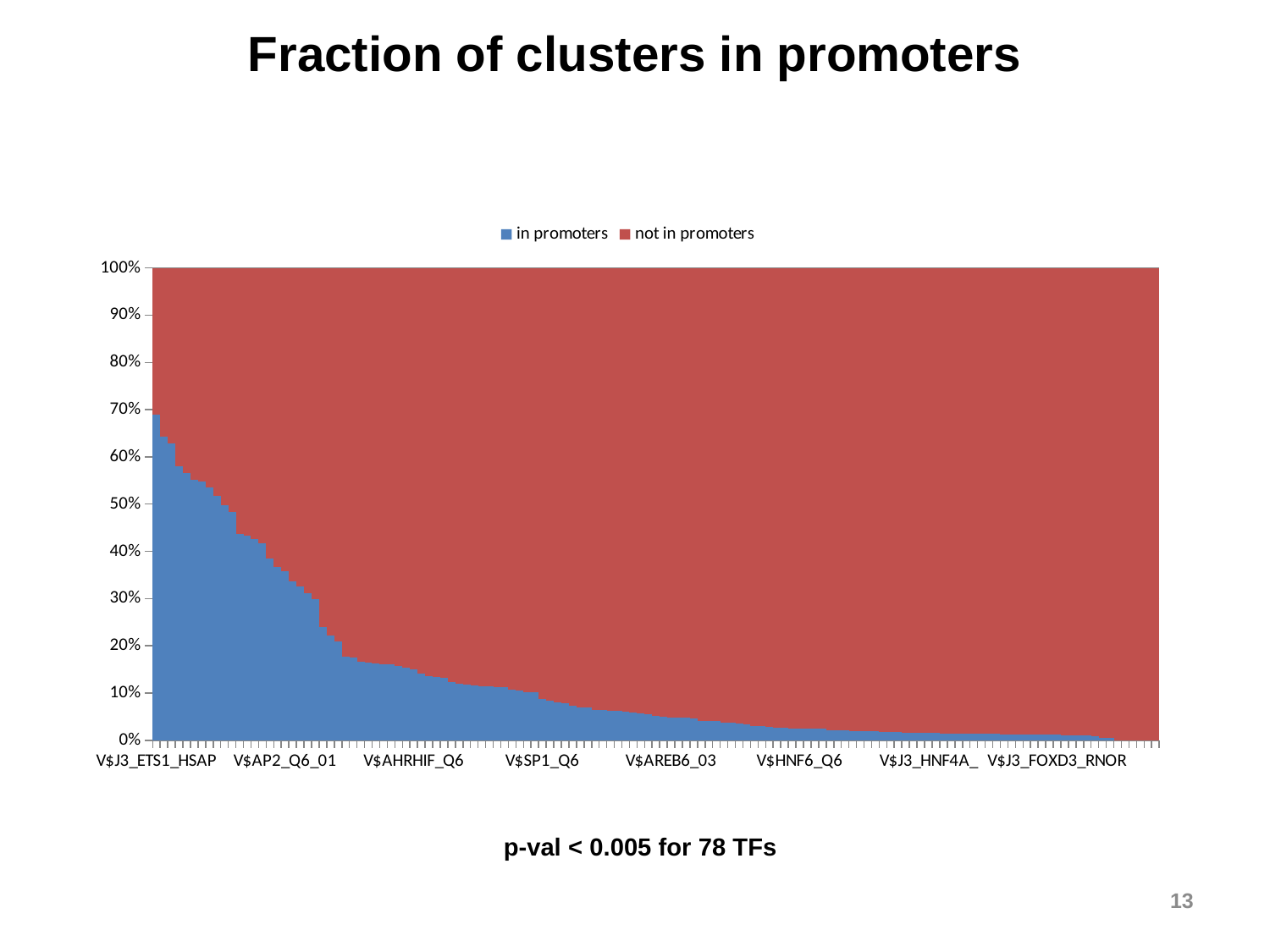
Is the 'in promoters' value for V$AP2_Q6_01 greater or less than 20%? greater Which series is shown in blue? in promoters Is the 'in promoters' value for V$AHRHIF_Q6 greater or less than 30%? less Is the 'in promoters' value for V$AREB6_03 greater or less than 10%? less What is the title of the chart? Fraction of clusters in promoters How many series does the legend list? 2 What kind of chart is shown on the slide? Stacked bar chart For V$HNF6_Q6, which is larger, the 'in promoters' segment or the 'not in promoters' segment? not in promoters Does the 'in promoters' fraction rise or fall moving from left to right along the x axis? Fall Which has the larger 'in promoters' fraction, V$J3_ETS1_HSAP or V$J3_FOXD3_RNOR? V$J3_ETS1_HSAP